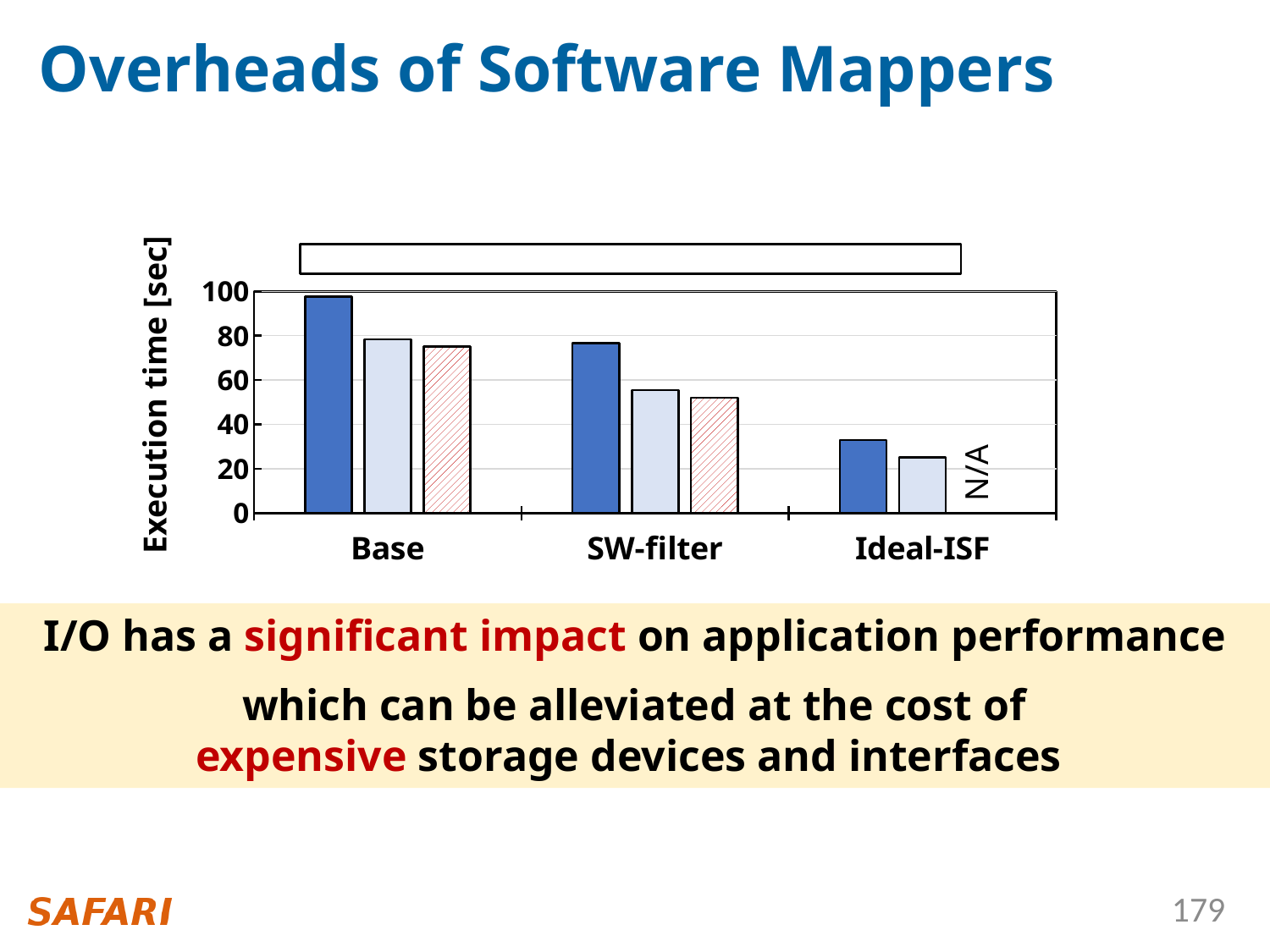
Is the light blue bar for SW-filter greater or less than 60? less What is the label of the y axis of the chart? Execution time [sec] How many categories are shown on the x axis of the chart? 3 Which category has the tallest dark blue bar? Base For which category is the red hatched bar marked N/A? Ideal-ISF Do the dark blue bars rise or fall from Base to Ideal-ISF? fall What kind of chart is shown on the slide? bar chart Is the red hatched bar for Base greater or less than 60? greater Is the dark blue bar for Base greater or less than 80? greater Which category has the shortest dark blue bar? Ideal-ISF Which is larger, the dark blue bar for Base or the dark blue bar for SW-filter? Base